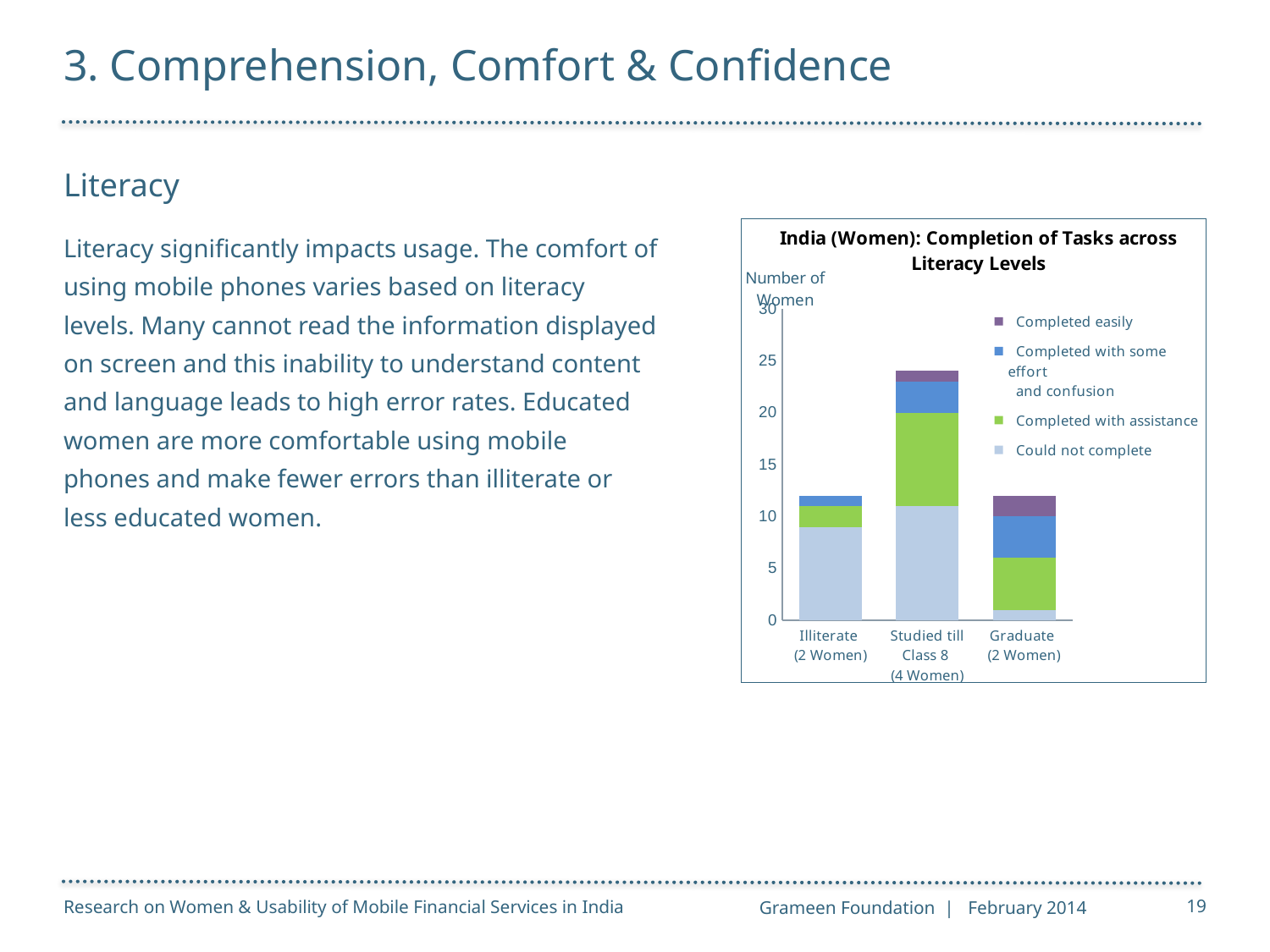
Is the 'Could not complete' segment for Graduate (2 Women) greater or less than 5? less Which has a larger 'Completed with assistance' segment: Studied till Class 8 (4 Women) or Illiterate (2 Women)? Studied till Class 8 (4 Women) Is the total stacked bar for Studied till Class 8 (4 Women) greater or less than 20? greater Which literacy level has the tallest stacked bar overall? Studied till Class 8 (4 Women) Is the total stacked bar for Illiterate (2 Women) greater or less than 15? less Which has a larger 'Could not complete' segment: Studied till Class 8 (4 Women) or Graduate (2 Women)? Studied till Class 8 (4 Women) What is the label on the vertical axis of the chart? Number of Women How many series does the chart's legend list? 4 What kind of chart is shown on the slide? Stacked bar chart What is the title of the chart? India (Women): Completion of Tasks across Literacy Levels How many literacy-level categories are shown on the x axis? 3 Which literacy level has the smallest 'Could not complete' segment? Graduate (2 Women)